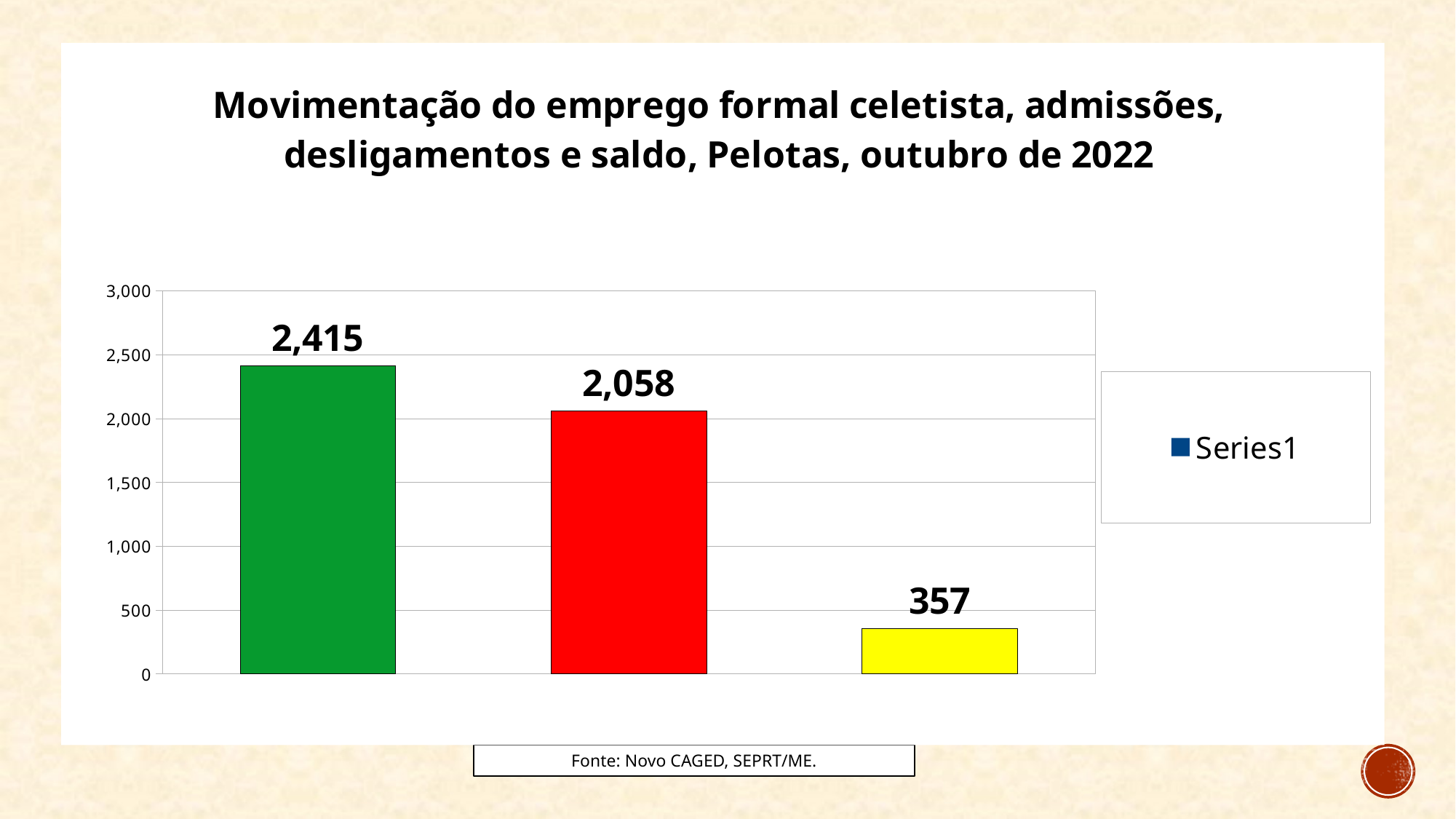
What is the value shown on the red bar (the middle bar)? 2,058 What is the source cited below the chart? Fonte: Novo CAGED, SEPRT/ME. What is the difference between the green bar's value and the red bar's value? 357 Which is larger, the value of the red bar or the value of the yellow bar? The red bar What kind of chart is shown on the slide? Bar chart How many series does the legend list? 1 Is the value of the yellow bar greater or less than 500? less What is the value shown on the green bar (the first bar from the left)? 2,415 Which bar has the lowest value? The yellow bar (rightmost), 357 What is the value shown on the yellow bar (the rightmost bar)? 357 How many bars are plotted in the chart? 3 Which bar has the highest value? The green bar (first from the left), 2,415